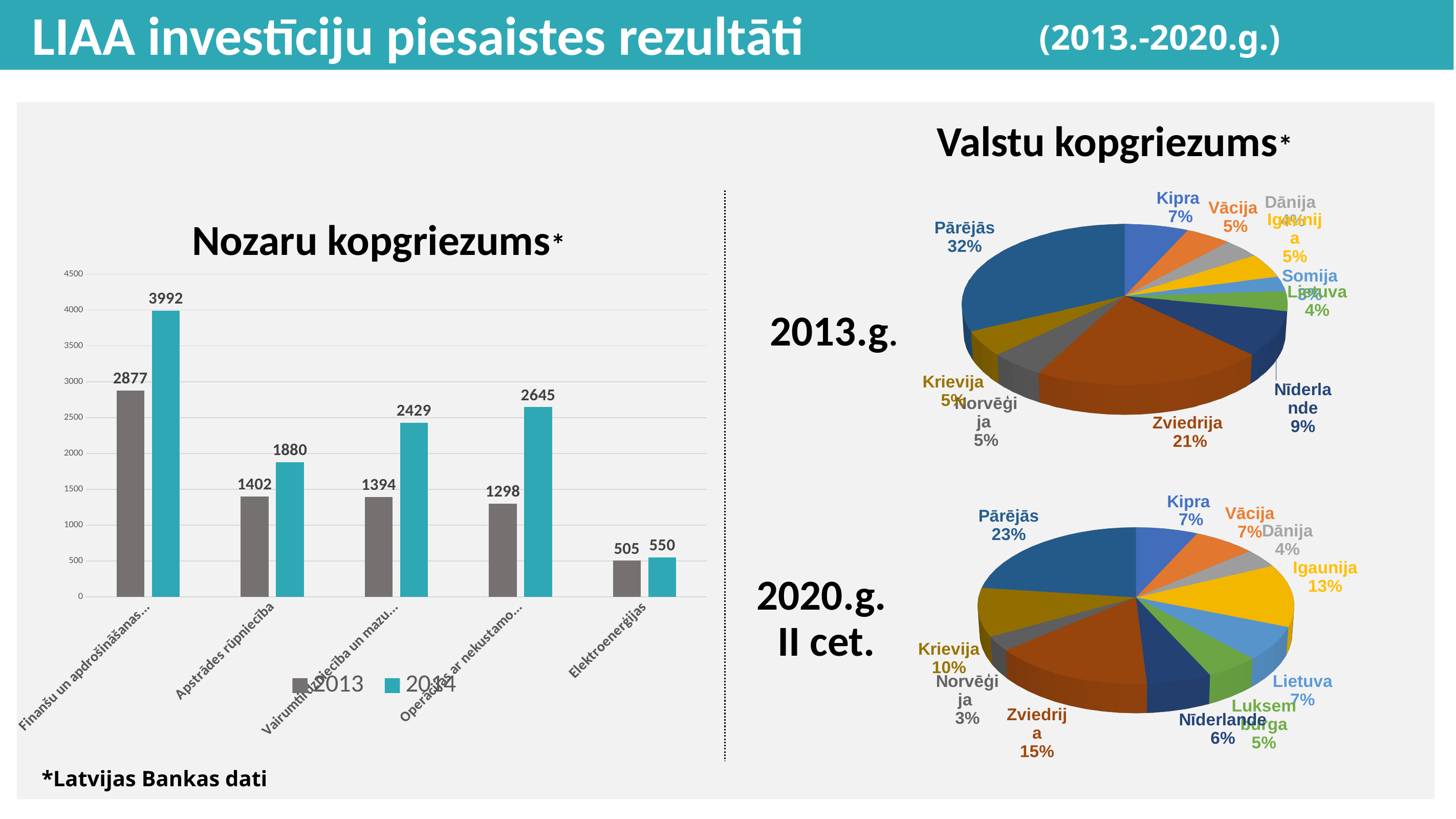
In the bar chart 'Nozaru kopgriezums', what is the 2014 value for Elektroenerģijas? 550 In the 2020.g. II cet. pie chart, which is larger, Krievija or Nīderlande? Krievija In the 2013.g. pie chart, which slice is the largest? Pārējās What type of chart is 'Nozaru kopgriezums'? bar chart In the bar chart 'Nozaru kopgriezums', what is the 2013 value for Apstrādes rūpniecība? 1402 In the bar chart 'Nozaru kopgriezums', which category has the highest 2014 value? Finanšu un apdrošināšanas... In the 2013.g. pie chart, what share does Zviedrija have? 21% In the bar chart 'Nozaru kopgriezums', how many series does the legend list? 2 In the bar chart 'Nozaru kopgriezums', which category has the lowest 2013 value? Elektroenerģijas In the bar chart 'Nozaru kopgriezums', what is the difference between the 2014 and 2013 values for Finanšu un apdrošināšanas...? 1115 In the bar chart 'Nozaru kopgriezums', how many categories are shown on the x axis? 5 In the 2020.g. II cet. pie chart, what share does Igaunija have? 13%